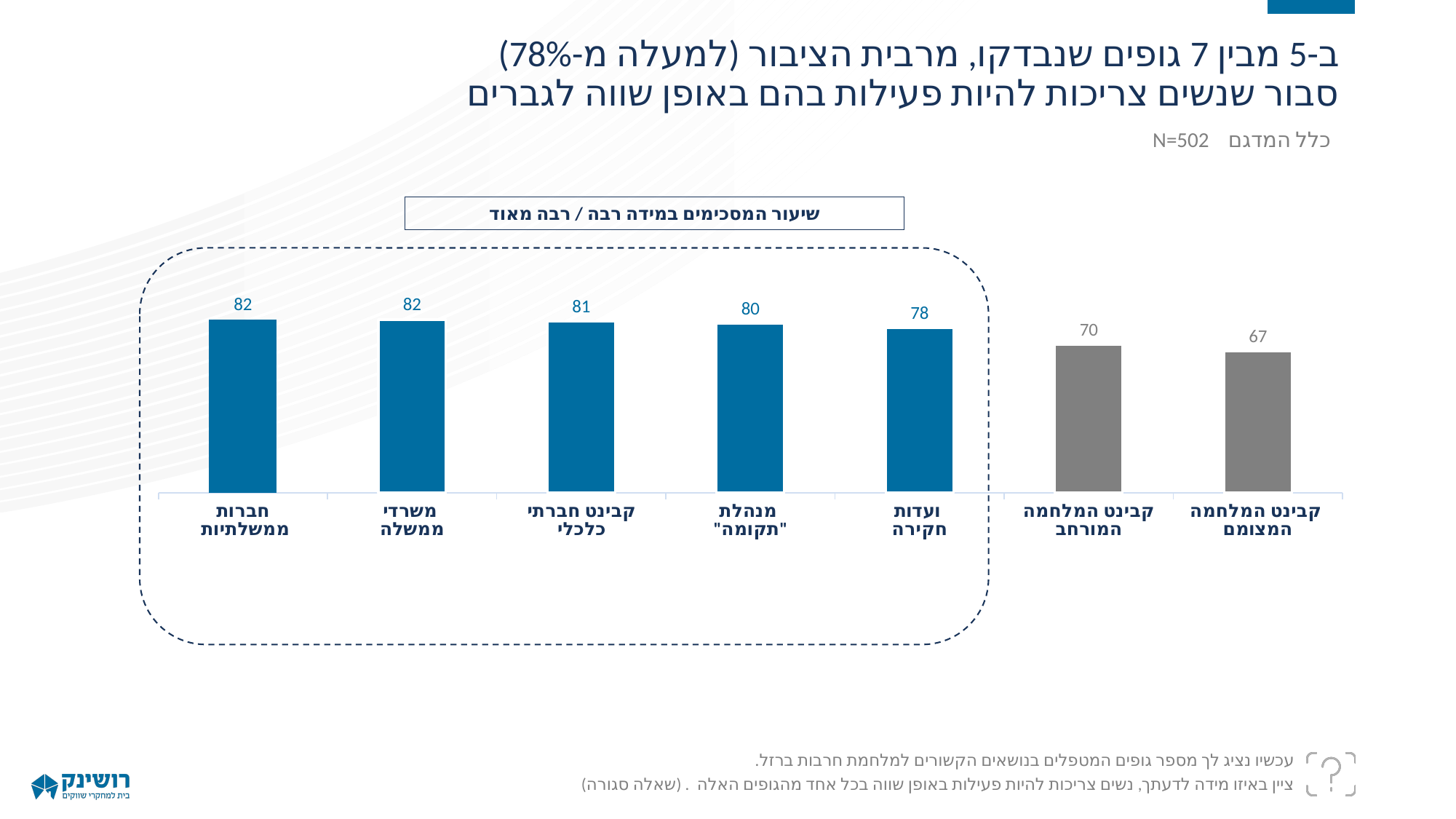
Do the values rise or fall moving from חברות ממשלתיות to קבינט המלחמה המצומצם? fall How many bars are coloured grey rather than blue? 2 What is the difference between the values for חברות ממשלתיות and קבינט המלחמה המצומצם? 15 What value is shown for ועדות חקירה? 78 What is the difference between the values for ועדות חקירה and קבינט המלחמה המורחב? 8 What value is shown for קבינט המלחמה המורחב? 70 Which category has the lowest value? קבינט המלחמה המצומם How many categories are shown in the chart? 7 What kind of chart is shown on the slide? bar chart What value is shown for מנהלת "תקומה"? 80 What value is shown for קבינט חברתי כלכלי? 81 Which is larger, the value for משרדי ממשלה or the value for קבינט המלחמה המורחב? משרדי ממשלה